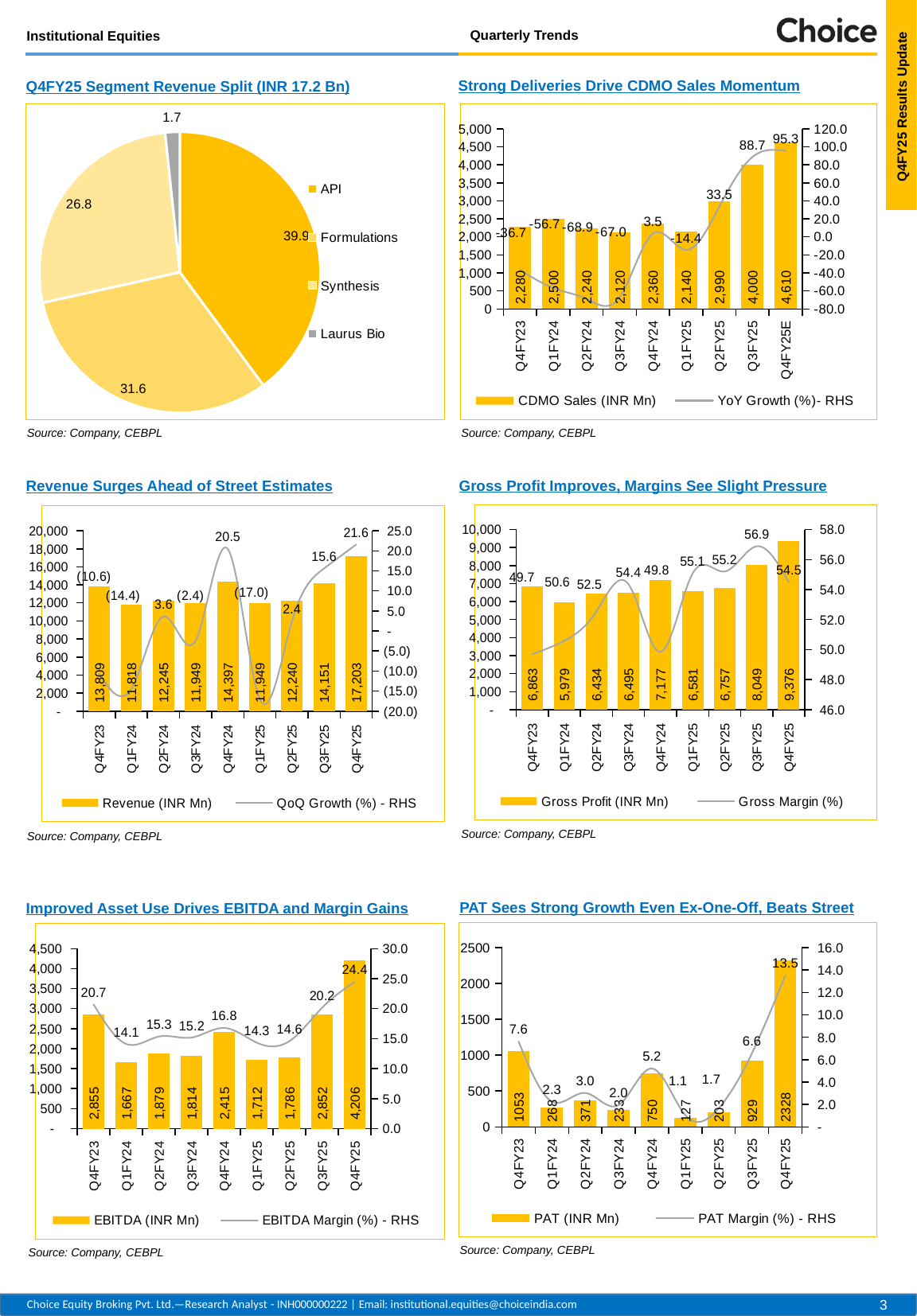
In the chart 'Strong Deliveries Drive CDMO Sales Momentum', what is the CDMO Sales value for Q4FY25E? 4,610 In the pie chart 'Q4FY25 Segment Revenue Split (INR 17.2 Bn)', what share does API account for? 39.9 In the pie chart 'Q4FY25 Segment Revenue Split (INR 17.2 Bn)', which segment has the smallest share? Laurus Bio In the chart 'Improved Asset Use Drives EBITDA and Margin Gains', is the EBITDA Margin (%) higher in Q4FY23 or Q3FY25? Q4FY23 In the chart 'Strong Deliveries Drive CDMO Sales Momentum', what is the YoY Growth (%) for Q2FY24? -68.9 In the chart 'Gross Profit Improves, Margins See Slight Pressure', which quarter has the lowest Gross Profit (INR Mn)? Q1FY24 In the chart 'PAT Sees Strong Growth Even Ex-One-Off, Beats Street', how many quarters are shown on the x axis? 9 In the chart 'Gross Profit Improves, Margins See Slight Pressure', what is the Gross Margin (%) for Q3FY25? 56.9 In the chart 'Revenue Surges Ahead of Street Estimates', which quarter has the highest Revenue (INR Mn)? Q4FY25 In the chart 'PAT Sees Strong Growth Even Ex-One-Off, Beats Street', what is the PAT (INR Mn) for Q1FY25? 127 In the chart 'Revenue Surges Ahead of Street Estimates', what is the difference in Revenue (INR Mn) between Q4FY25 and Q3FY25? 3,052 In the chart 'Improved Asset Use Drives EBITDA and Margin Gains', what is the EBITDA (INR Mn) for Q4FY24? 2,415